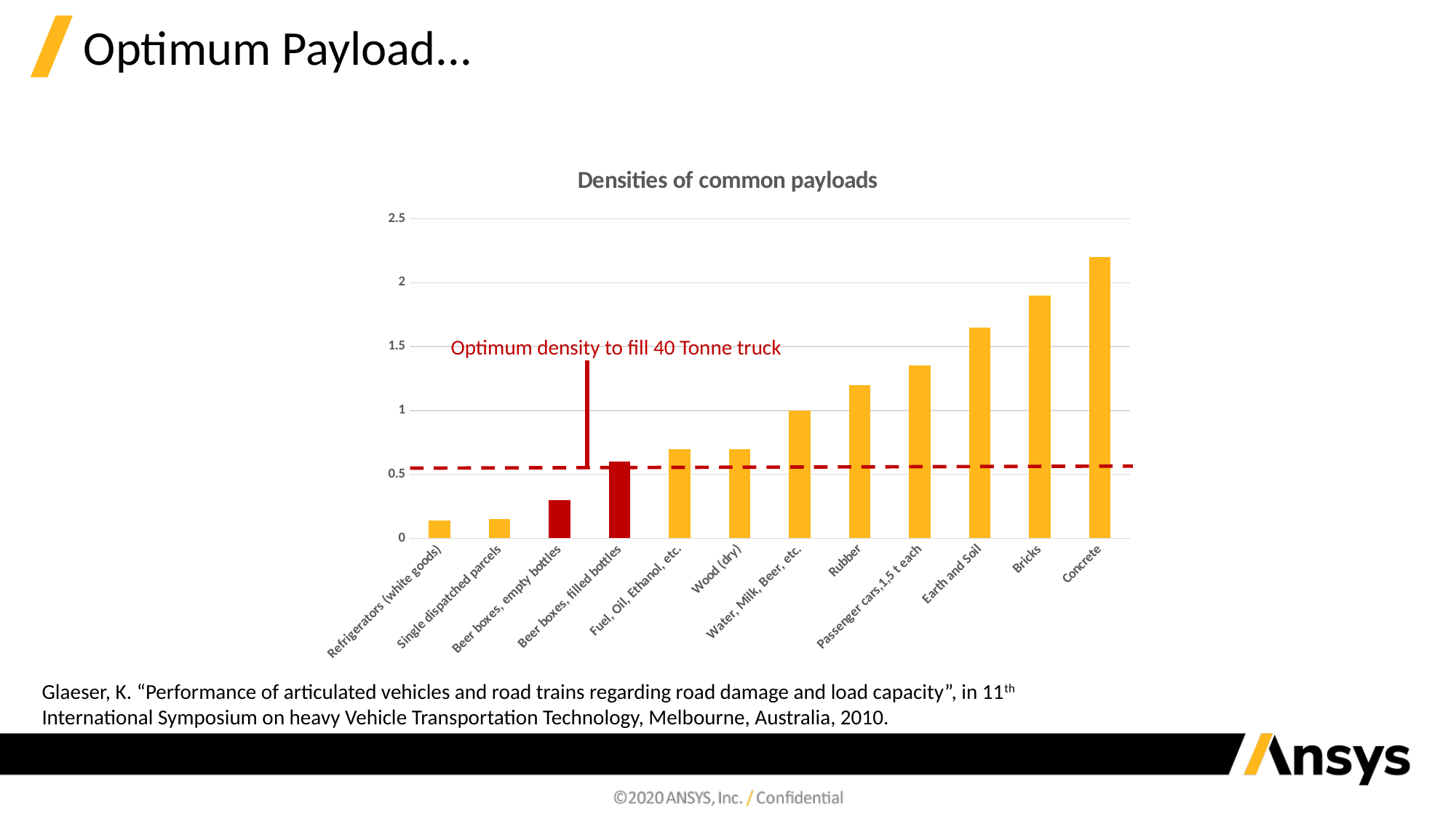
Is the value for Concrete greater or less than 2? greater Which has a higher density, Concrete or Bricks? Concrete What is the title of the chart? Densities of common payloads Do the bar values rise or fall from left to right along the x axis? rise Is the value for Bricks greater or less than 2? less What does the red annotation text on the chart say? Optimum density to fill 40 Tonne truck How many payload categories are plotted in the chart? 12 Which payload category has the highest density in the chart? Concrete Is the value for Earth and Soil greater or less than 1.5? greater What kind of chart is shown on the slide? bar chart Which has a higher density, Rubber or Wood (dry)? Rubber